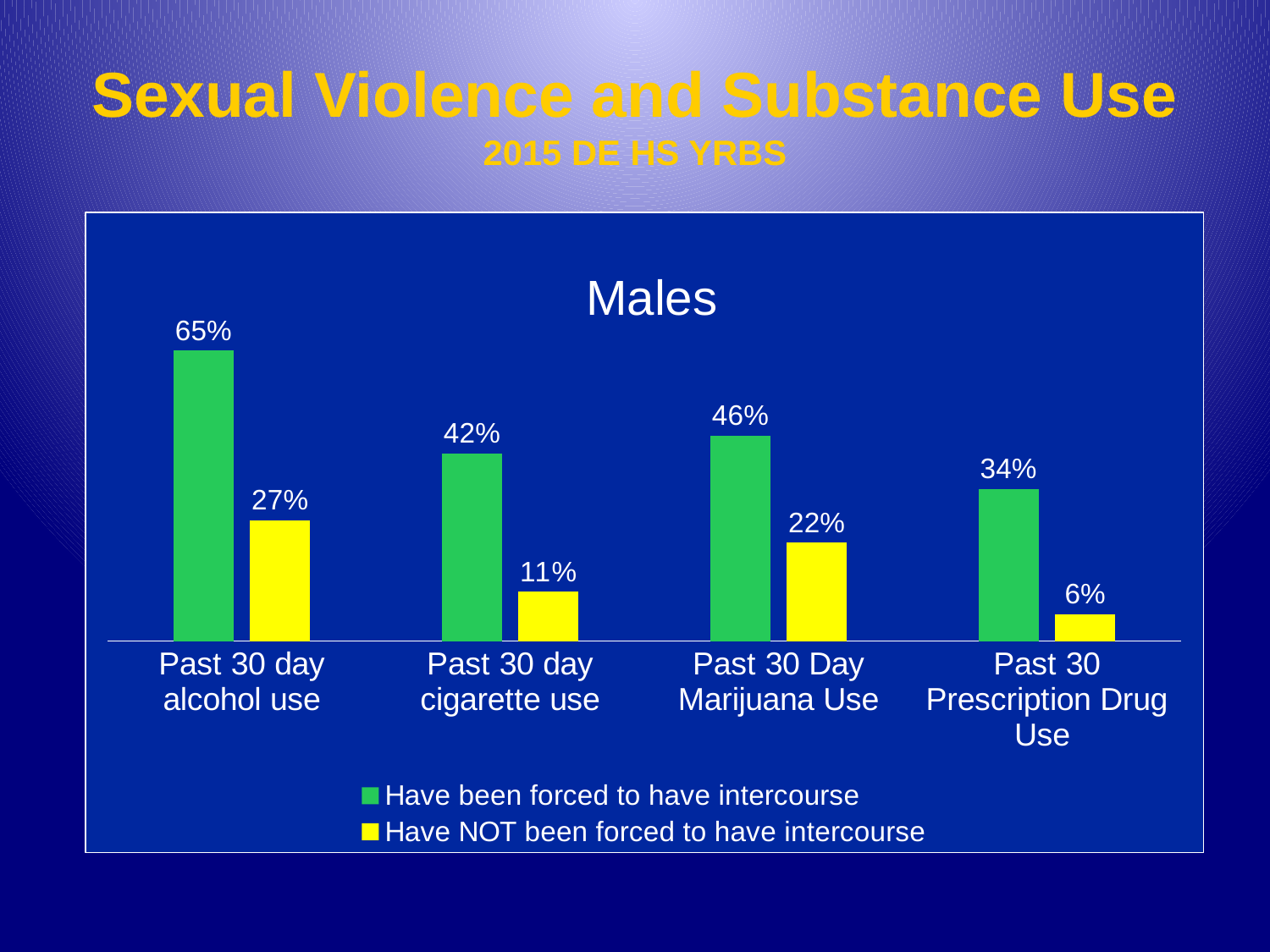
What is the difference between the 'Have been forced to have intercourse' values for Past 30 day alcohol use and Past 30 day cigarette use? 23% Which category has the highest value for 'Have been forced to have intercourse'? Past 30 day alcohol use What is the difference between the two series for Past 30 Day Marijuana Use? 24% How many categories are shown on the x axis? 4 What is the value for 'Have NOT been forced to have intercourse' for Past 30 day cigarette use? 11% What is the value for 'Have been forced to have intercourse' for Past 30 day alcohol use? 65% What is the title of the chart? Males Which is larger: the 'Have NOT been forced to have intercourse' value for Past 30 day alcohol use or for Past 30 Day Marijuana Use? Past 30 day alcohol use What kind of chart is shown? Bar chart What is the value for 'Have NOT been forced to have intercourse' for Past 30 Prescription Drug Use? 6% How many series does the legend list? 2 Which category has the lowest value for 'Have NOT been forced to have intercourse'? Past 30 Prescription Drug Use